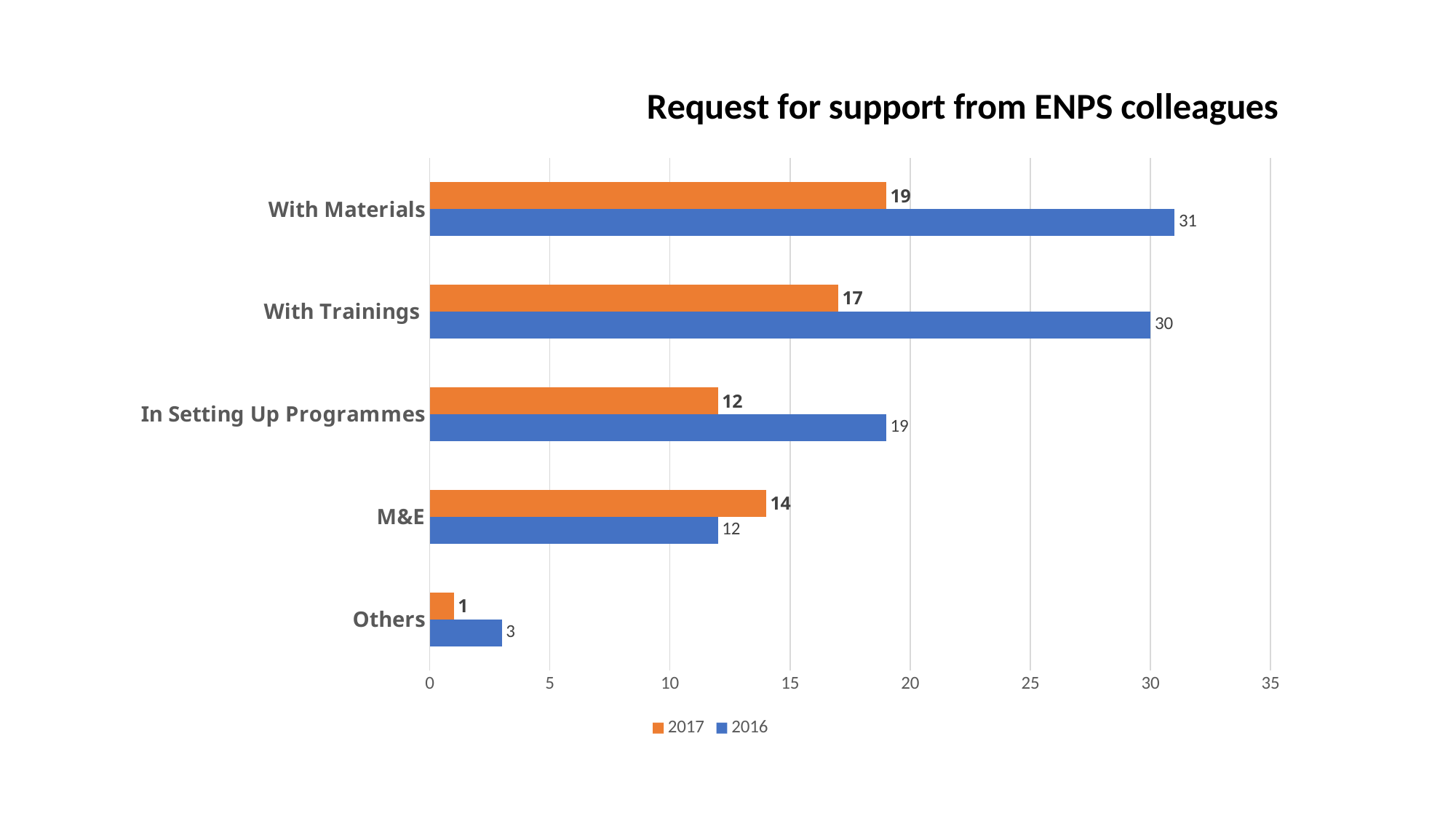
Which category has the highest 2017 value? With Materials What is the 2016 value for In Setting Up Programmes? 19 Is the 2016 value for With Materials greater or less than 30? greater What is the 2017 value for With Trainings? 17 How many categories are shown on the chart? 5 What kind of chart is shown on the slide? Bar chart For M&E, which year has the larger value, 2017 or 2016? 2017 Which category has the lowest 2016 value? Others What is the title of the chart? Request for support from ENPS colleagues How many series does the legend list? 2 What is the difference between the 2016 and 2017 values for With Trainings? 13 What is the 2016 value for With Materials? 31